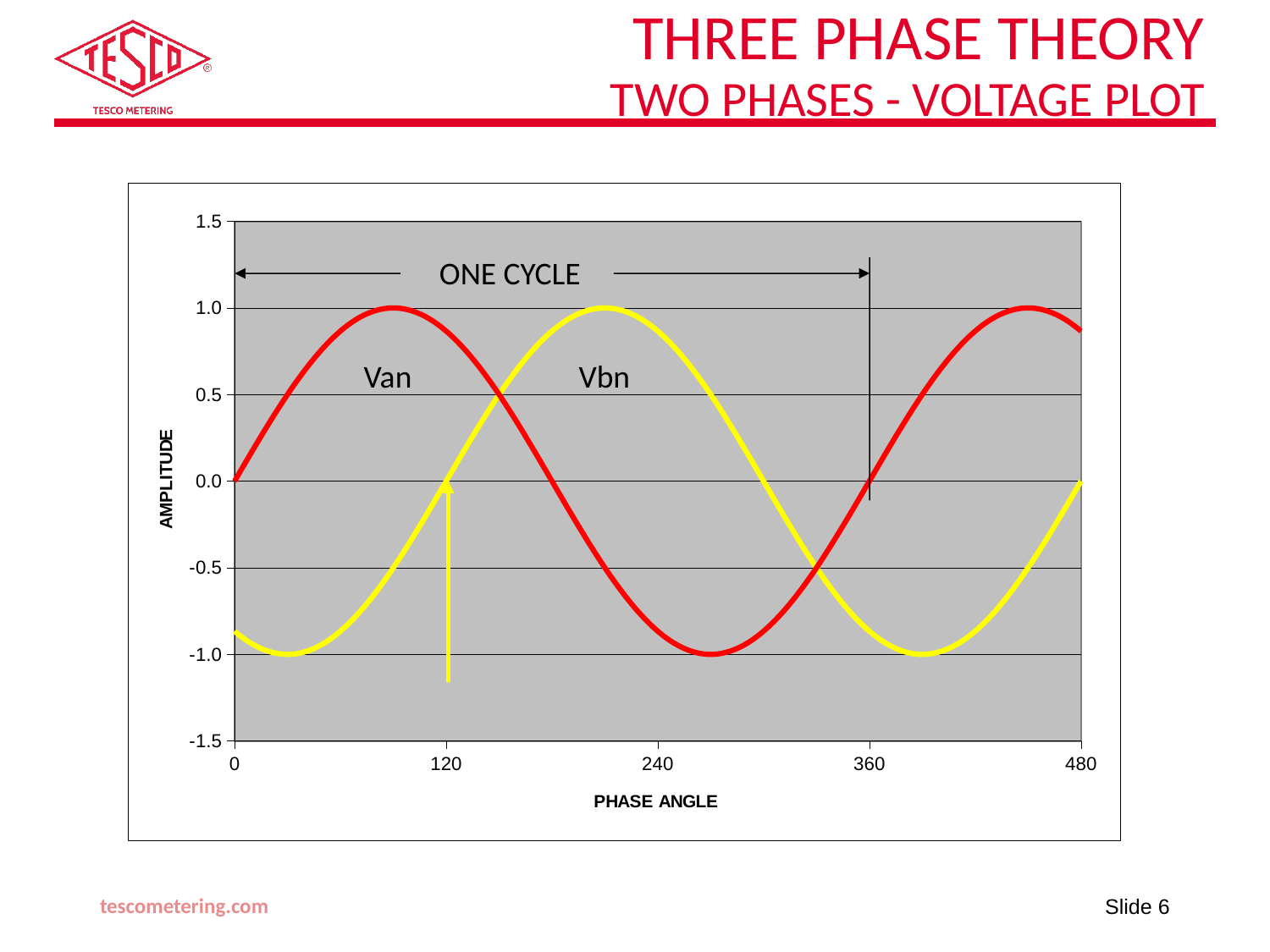
Is the value of Vbn at a phase angle of 0 greater or less than -0.5? less Is the value of Van at a phase angle of 120 greater or less than 0.5? greater What is the minimum amplitude reached by Vbn? -1.0 What is the value of Van at a phase angle of 360? 0.0 What is the maximum amplitude reached by Van? 1.0 How many series are plotted on the chart? 2 At a phase angle of 240, which series has the larger value, Van or Vbn? Vbn Does Van rise or fall between phase angles 120 and 240? fall What is the title of the x axis? PHASE ANGLE What is the value of Van at a phase angle of 0? 0.0 What kind of chart is shown on the slide? line chart What is the value of Vbn at a phase angle of 120? 0.0